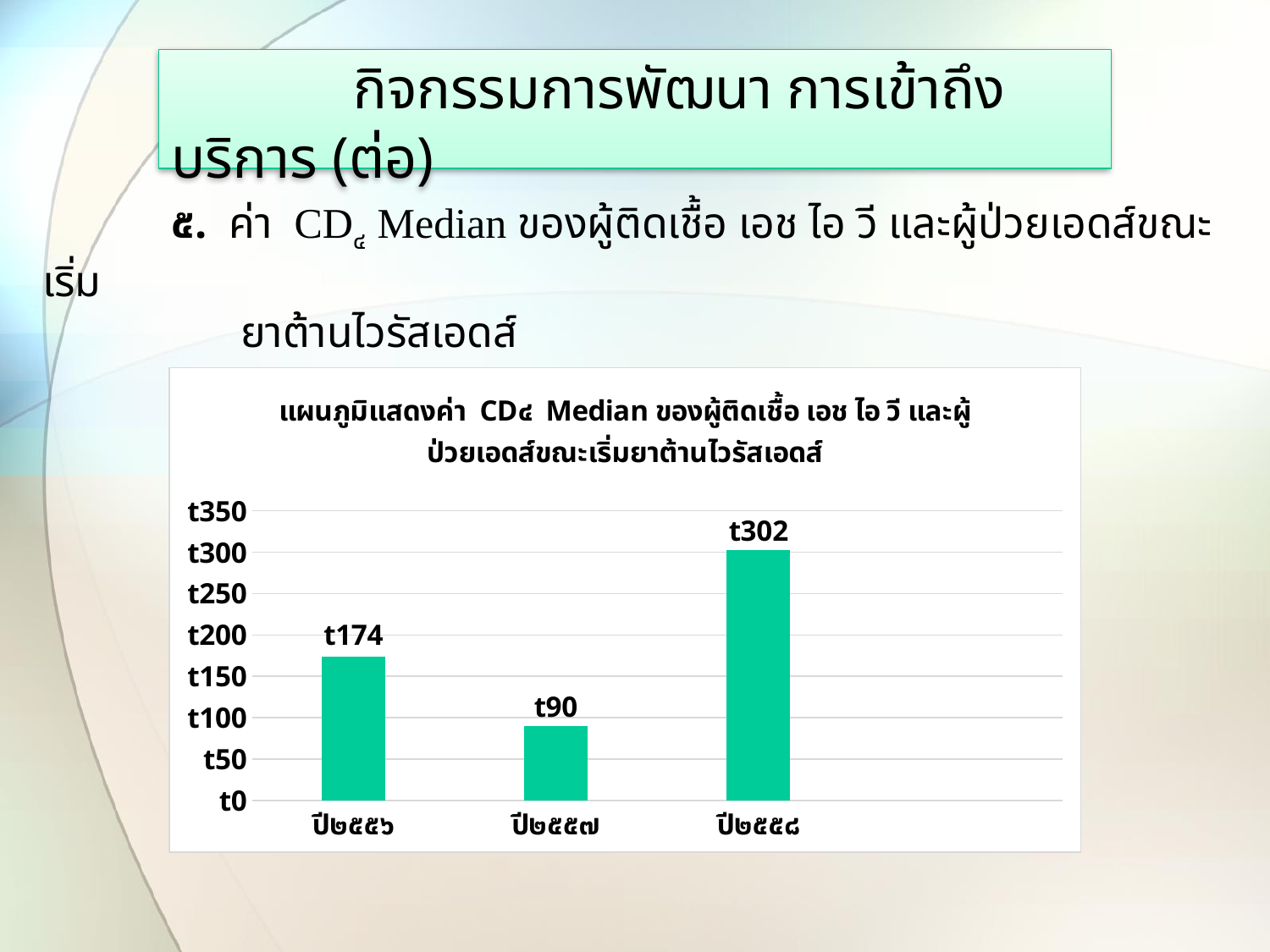
What kind of chart is shown on the slide? bar chart Which is larger, the value for ปี๒๕๕๖ or ปี๒๕๕๗? ปี๒๕๕๖ What is the value for ปี๒๕๕๗? t90 What is the value for ปี๒๕๕๖? t174 What is the difference between the values for ปี๒๕๕๖ and ปี๒๕๕๗? t84 Which year has the highest value? ปี๒๕๕๘ What is the highest tick value shown on the y axis? t350 How many years are shown on the x axis? 3 Which year has the lowest value? ปี๒๕๕๗ Is the value for ปี๒๕๕๘ greater or less than t250? greater What is the value for ปี๒๕๕๘? t302 What is the difference between the values for ปี๒๕๕๘ and ปี๒๕๕๖? t128